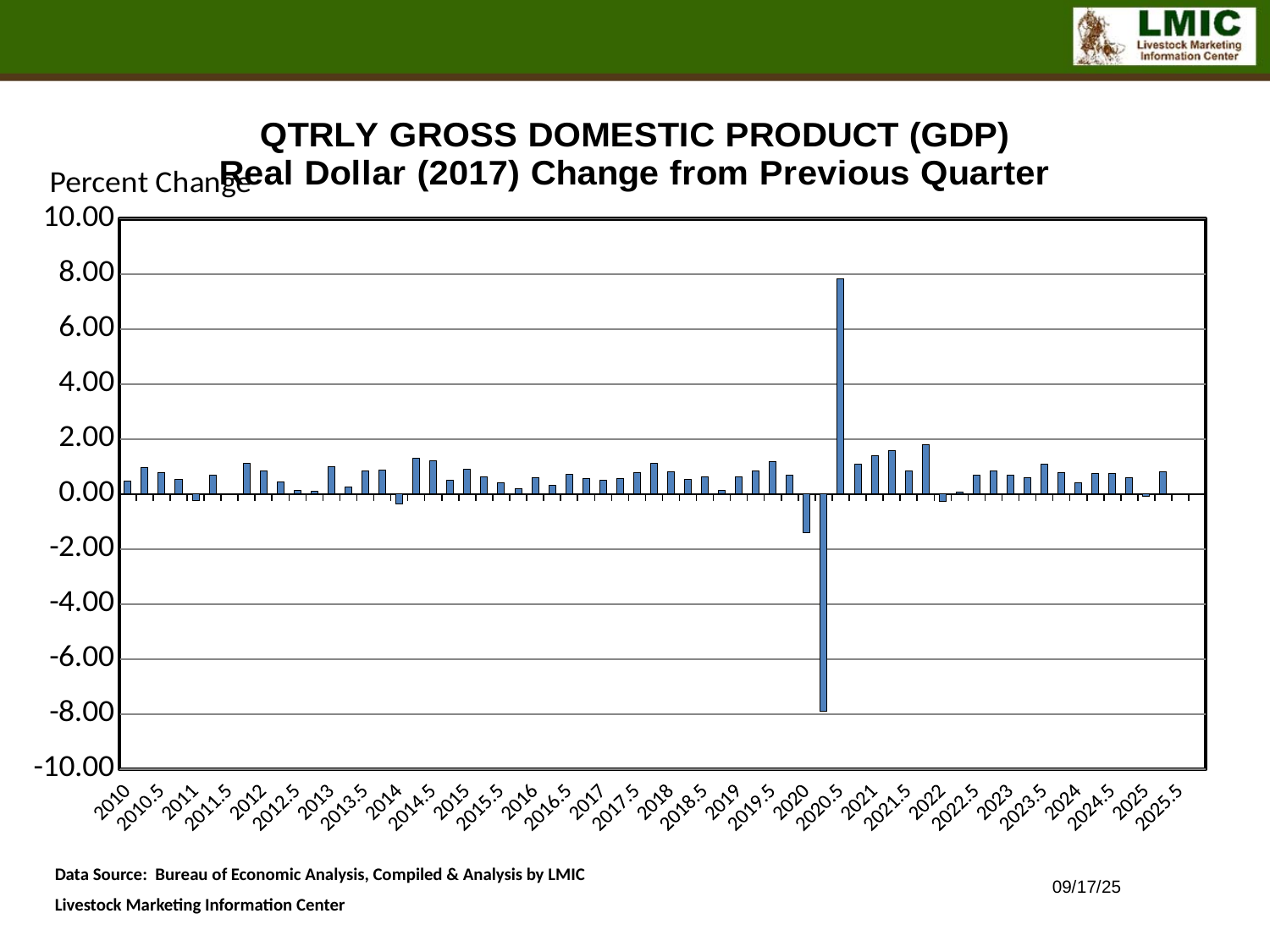
Which has the larger value, 2020.5 or 2022? 2020.5 What kind of chart is shown on the slide? bar chart Which has the larger value, 2012 or 2012.5? 2012 What is the title of the chart? QTRLY GROSS DOMESTIC PRODUCT (GDP) Real Dollar (2017) Change from Previous Quarter Is the lowest value on the chart greater or less than -6? less What is the first x-axis label on the chart? 2010 Is the value for 2022 greater or less than 2? less What is the highest value shown on the vertical axis? 10.00 Is the value for 2014 greater or less than 0? less Which x-axis category has the highest value on the chart? 2020.5